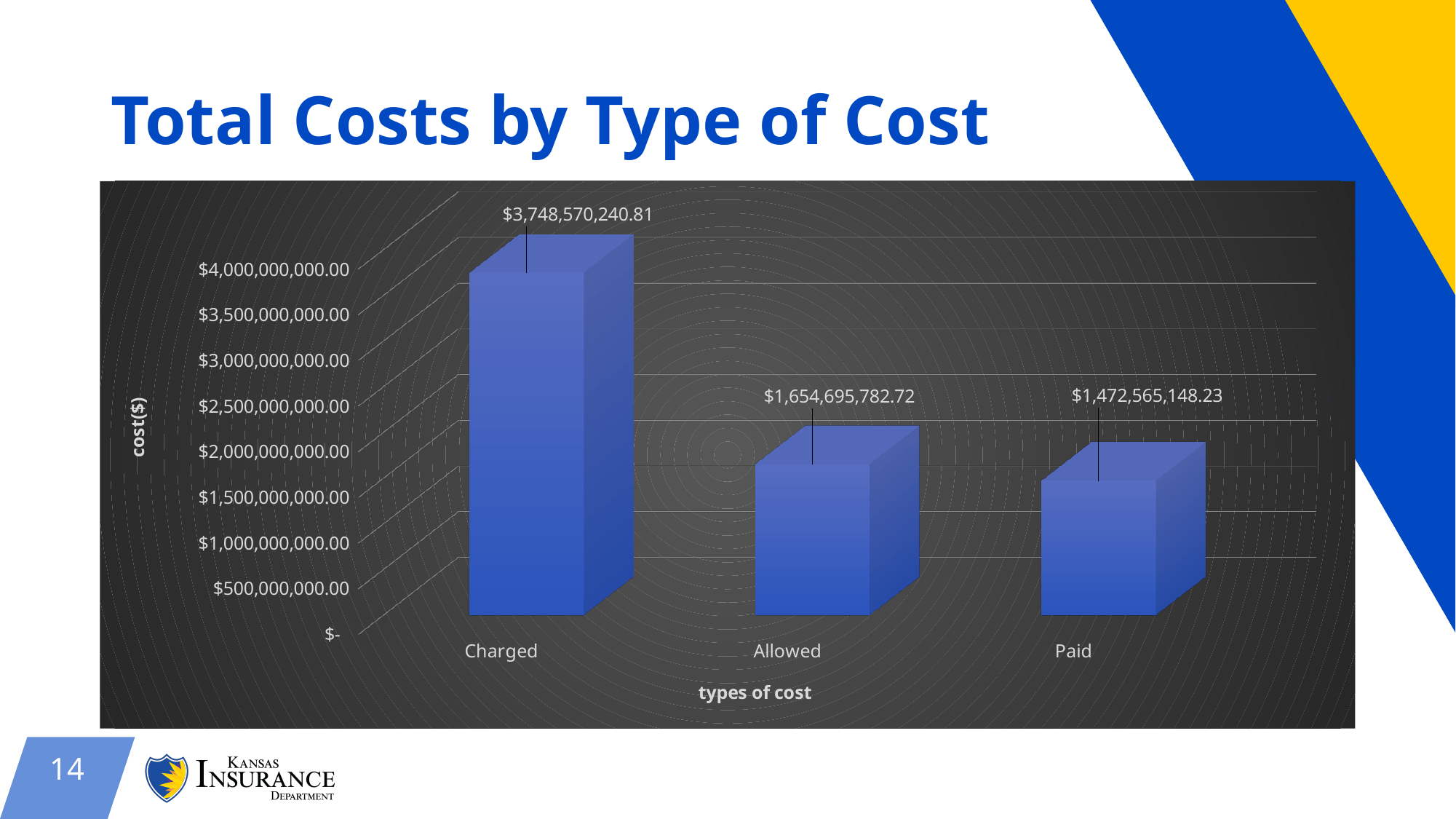
Which type of cost has the lowest total? Paid What is the value for Paid? $1,472,565,148.23 What kind of chart is shown on the slide? bar chart Which is larger, the value for Charged or the value for Paid? Charged How many types of cost are shown on the chart? 3 What is the value for Charged? $3,748,570,240.81 What is the value for Allowed? $1,654,695,782.72 Is the value for Charged greater or less than $3,500,000,000.00? greater What is the difference between the Charged and Allowed values? $2,093,874,458.09 What is the label of the vertical axis? cost($) What is the difference between the Allowed and Paid values? $182,130,634.49 Which type of cost has the highest total? Charged